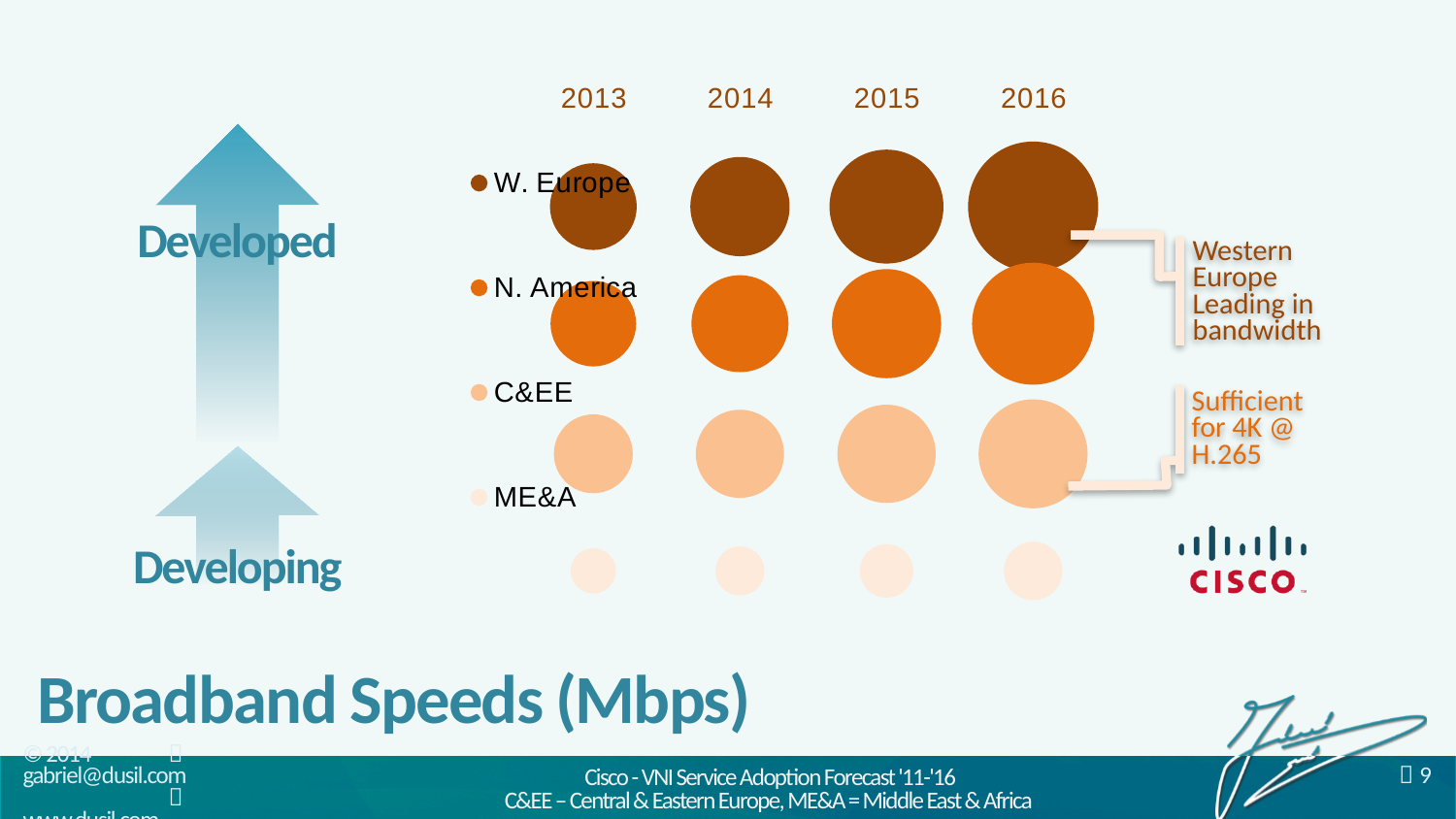
Do the bubble sizes for W. Europe rise or fall from 2013 to 2016? rise Which region has the smallest bubbles in the chart? ME&A How many years are shown along the top of the chart? 4 What is the title of the chart? Broadband Speeds (Mbps) What kind of chart is shown on the slide? bubble chart How many regions (series) does the chart's legend list? 4 In 2016, which region has the larger bubble, W. Europe or ME&A? W. Europe In 2013, which region has the larger bubble, N. America or C&EE? N. America Which region has the largest bubbles in the chart? W. Europe Which years are shown across the top of the chart? 2013, 2014, 2015, 2016 Which region is listed first (at the top) in the chart's legend? W. Europe Do the bubble sizes for N. America rise or fall from 2013 to 2016? rise